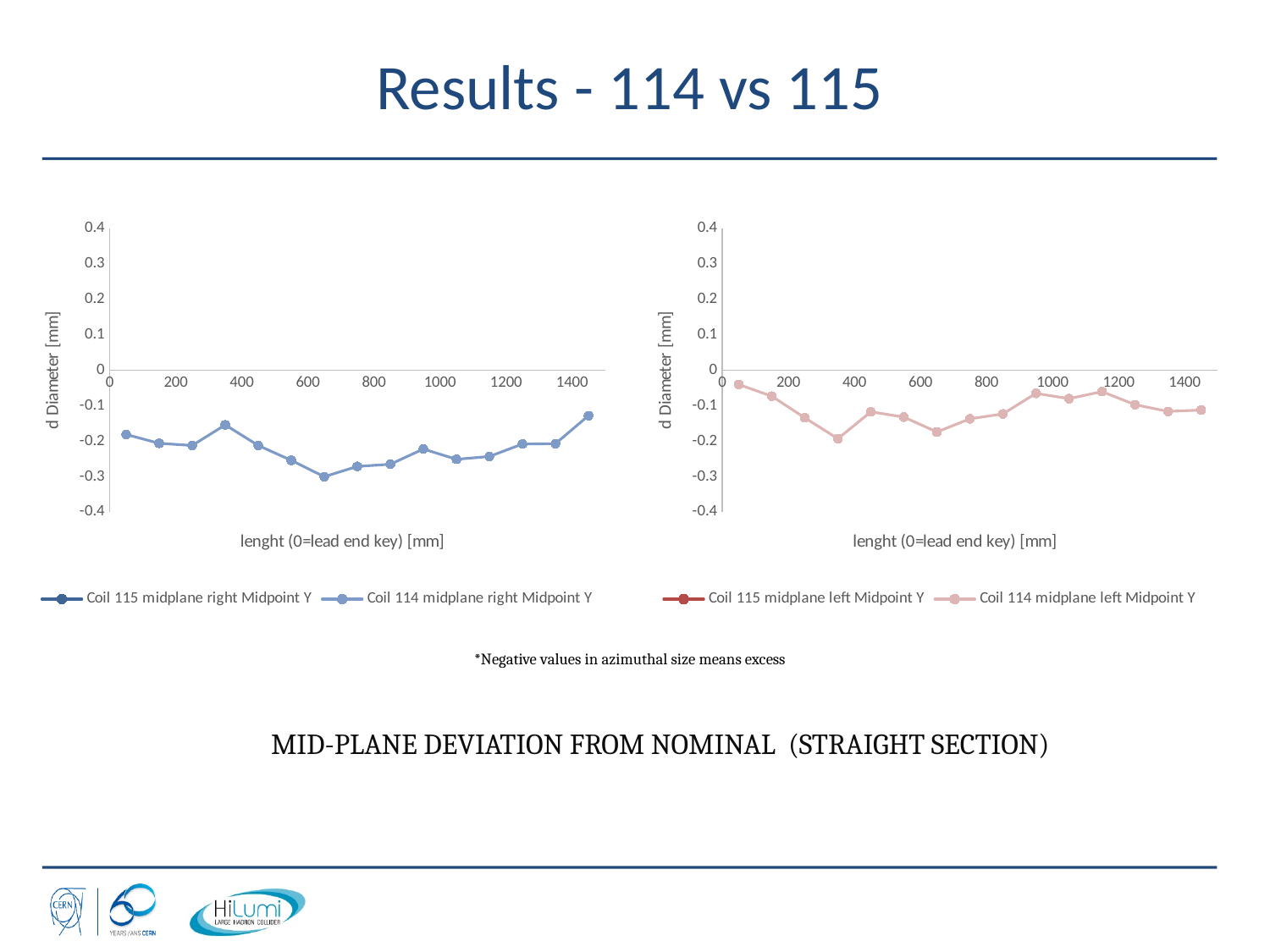
On the left chart, at which length (in mm) does the plotted line reach its lowest value? 650 What kind of chart is the left chart on the slide? line chart How many series does the legend of the right chart list? 2 How many data points are plotted on the left chart? 15 On the left chart, is the value of the plotted line at length 650 mm greater or less than -0.2? less What is the y-axis label of the left chart? d Diameter [mm] On the left chart, which is larger: the value at length 350 mm or the value at length 650 mm? 350 mm On the right chart, at which length (in mm) does the plotted line reach its lowest value? 350 What is the x-axis label of the right chart? lenght (0=lead end key) [mm] How many data points are plotted on the right chart? 15 On the right chart, is the value of the plotted line at length 50 mm greater or less than -0.1? greater On the left chart, at which length (in mm) does the plotted line reach its highest value? 1450